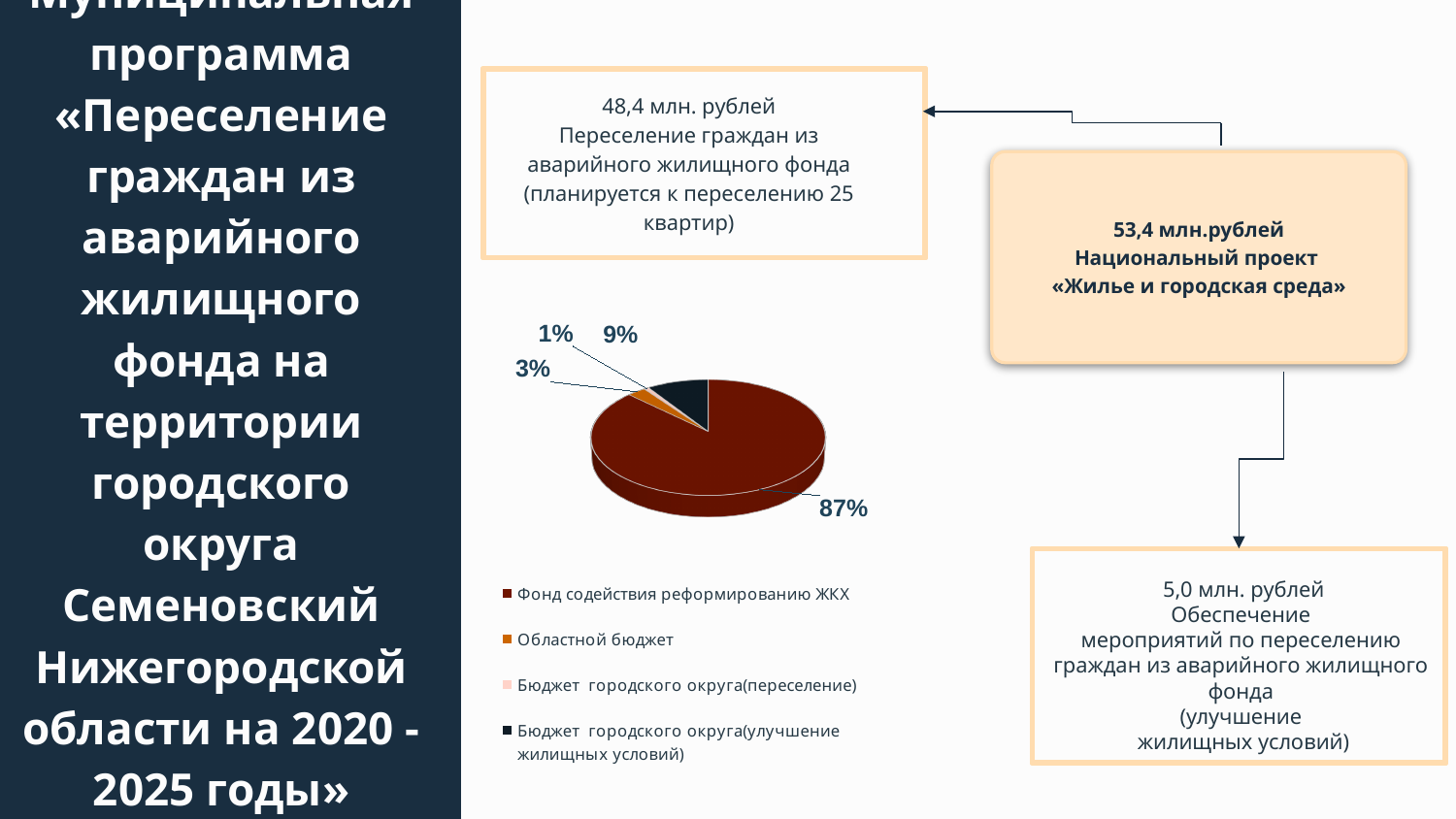
What share of the pie does "Бюджет городского округа(переселение)" hold? 1% What colour is the slice for "Фонд содействия реформированию ЖКХ"? dark red How many slices does the pie chart have? 4 Which category has the smallest slice of the pie? Бюджет городского округа(переселение) What share of the pie does "Областной бюджет" hold? 3% Which is larger: the share for "Областной бюджет" or the share for "Бюджет городского округа(улучшение жилищных условий)"? Бюджет городского округа(улучшение жилищных условий) What share of the pie does "Бюджет городского округа(улучшение жилищных условий)" hold? 9% How many entries does the legend of the pie chart list? 4 Which category has the largest slice of the pie? Фонд содействия реформированию ЖКХ What is the difference in percentage points between the largest slice and the slice for "Бюджет городского округа(улучшение жилищных условий)"? 78 What kind of chart is shown on the slide? pie chart